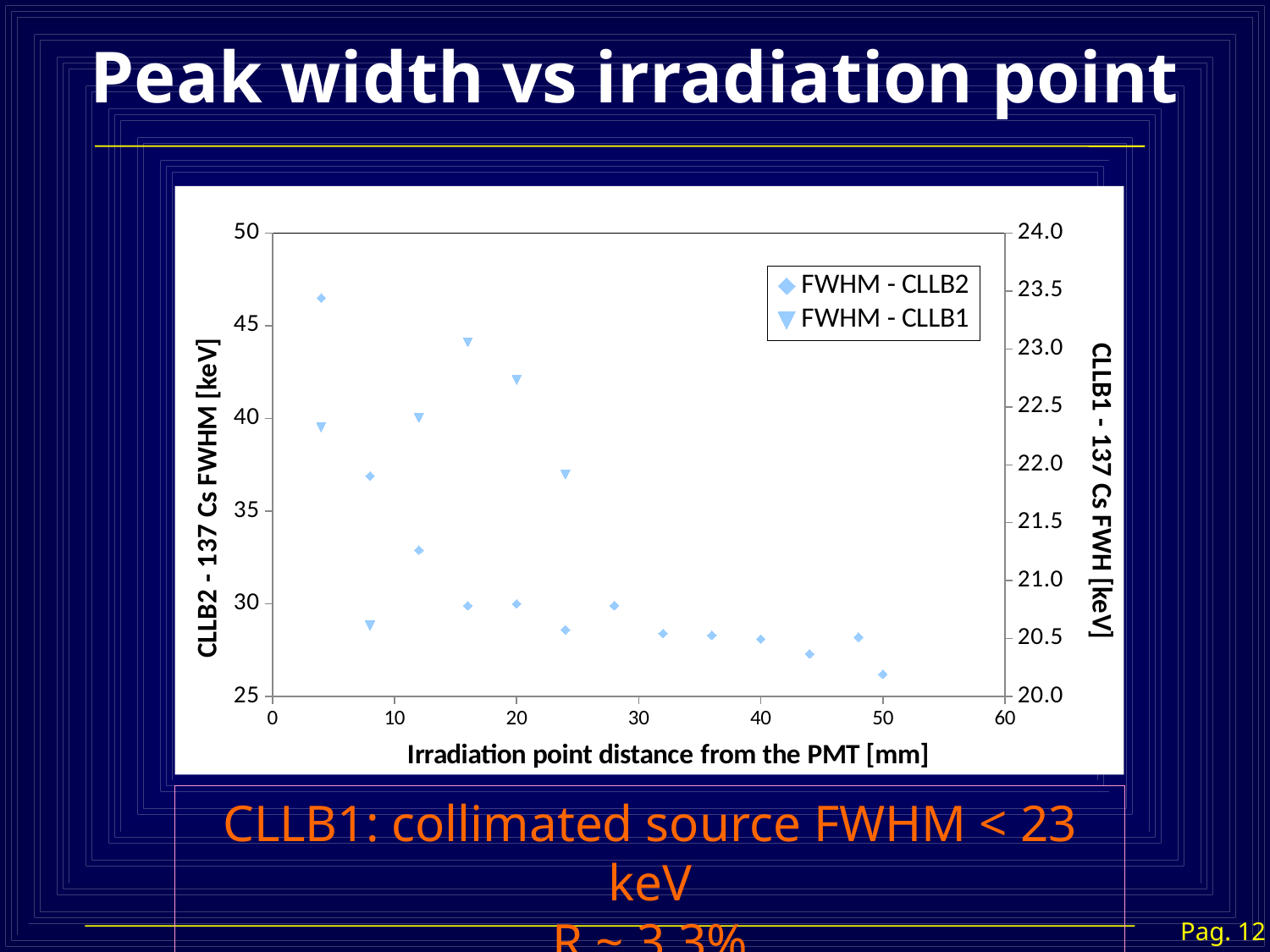
How many series does the legend list? 2 How many data points are plotted for the FWHM - CLLB2 series? 13 How many data points are plotted for the FWHM - CLLB1 series? 6 What are the two series named in the legend? FWHM - CLLB2 and FWHM - CLLB1 Is the FWHM - CLLB2 value at 4 mm greater or less than 45 on the left axis? greater Is the FWHM - CLLB1 value at 8 mm greater or less than 21.0 on the right axis? less Do the FWHM - CLLB2 values generally rise or fall as the irradiation point distance increases? fall At which irradiation point distance is the FWHM - CLLB2 value highest? 4 mm What kind of chart is shown on the slide? Scatter chart Is the FWHM - CLLB2 value at 50 mm greater or less than 30 on the left axis? less What is the title of the chart? Peak width vs irradiation point